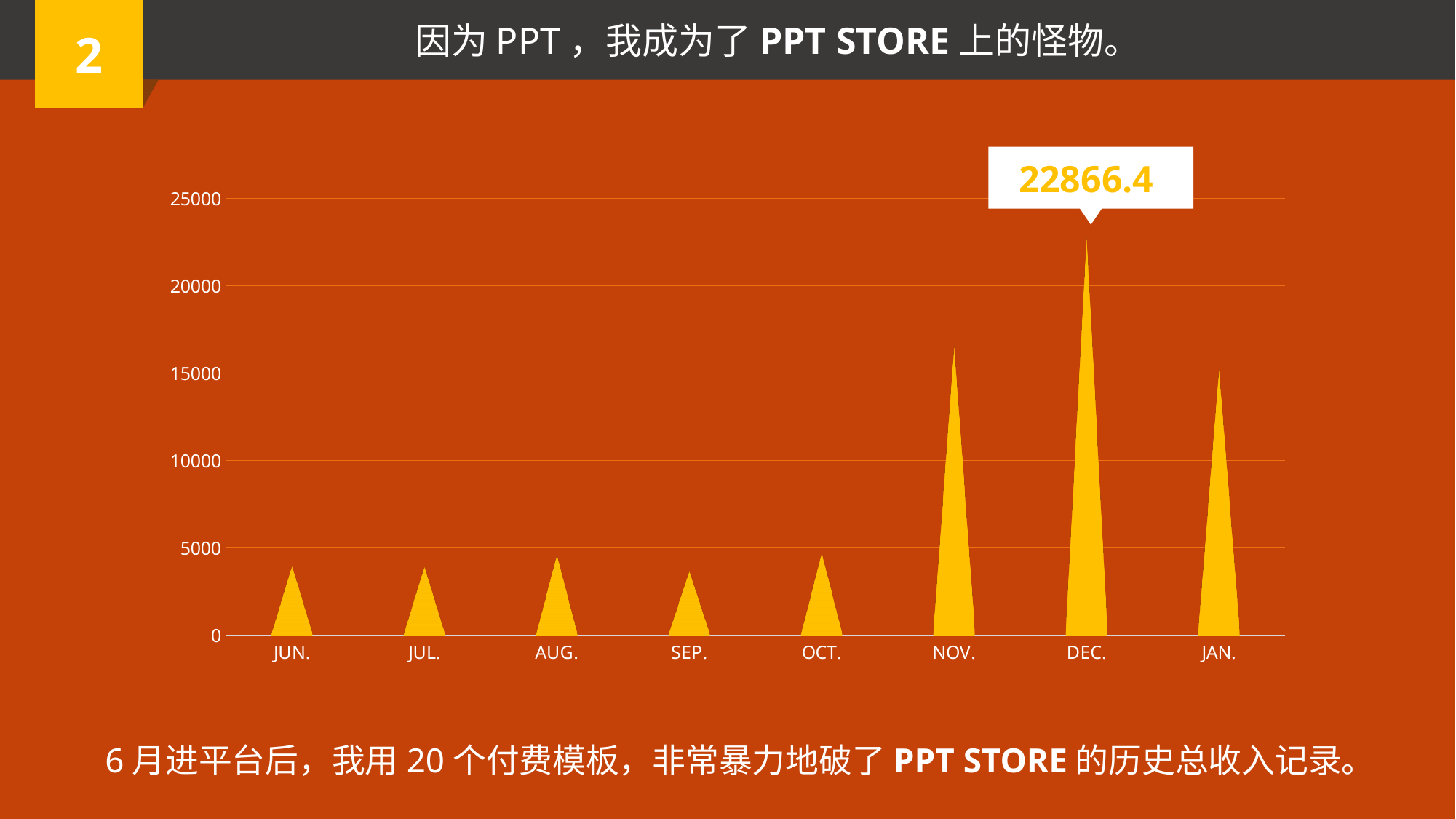
Is the value for DEC. greater or less than 20000? greater Do the values rise or fall from OCT. to DEC.? rise What value is labelled for DEC. on the chart? 22866.4 Is the value for JUN. greater or less than 5000? less Is the value for NOV. greater or less than 15000? greater Which is larger, the value for NOV. or the value for JAN.? NOV. Which month has the highest value on the chart? DEC. How many months are shown on the x axis of the chart? 8 What kind of chart is shown on the slide? bar chart Which is larger, the value for DEC. or the value for NOV.? DEC. What is the highest value shown on the chart's vertical axis? 25000